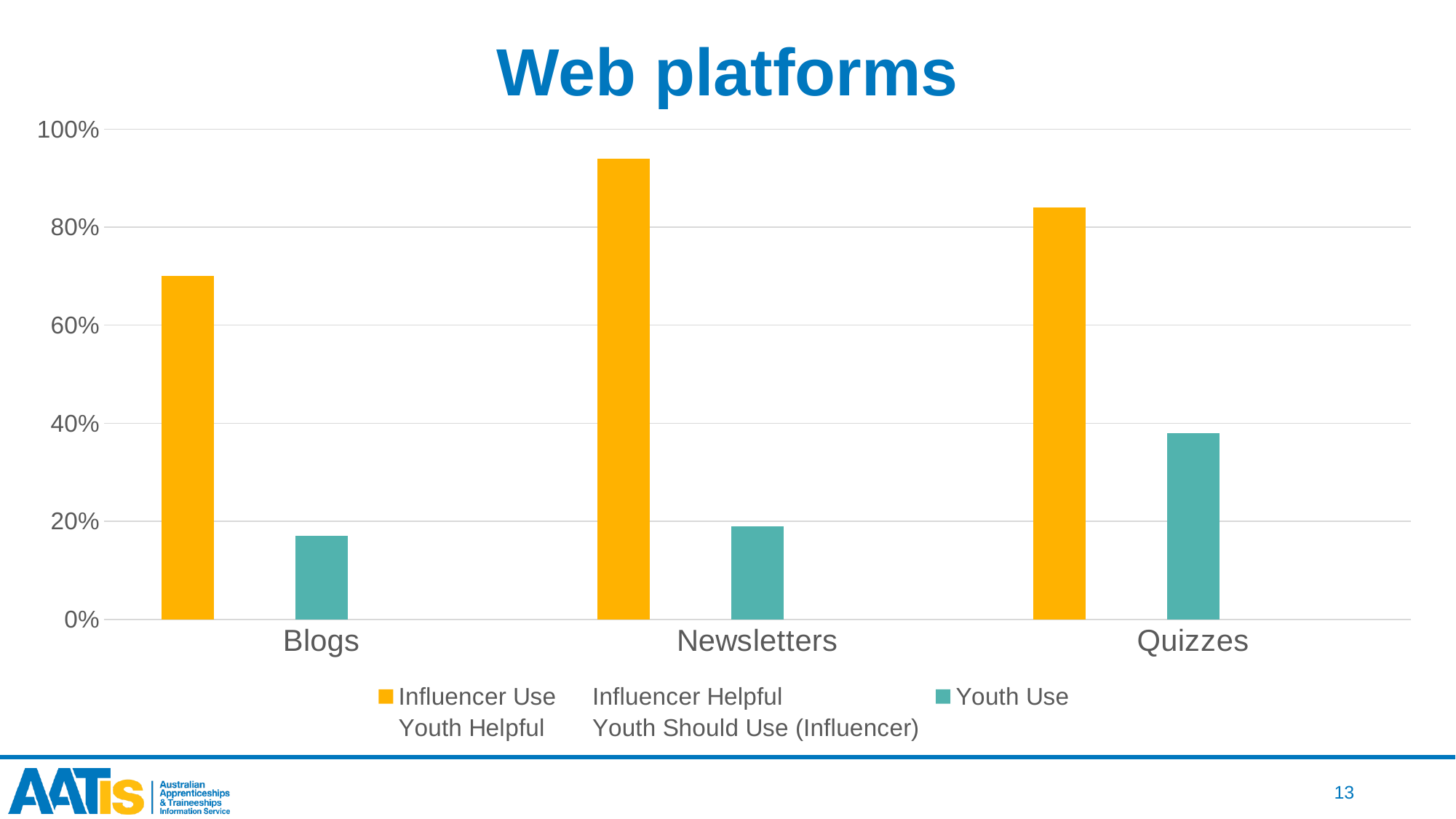
For Quizzes, which is larger: Influencer Use or Youth Use? Influencer Use Is the Youth Use value for Quizzes greater or less than 40%? less Which category has the lowest Influencer Use value? Blogs How many categories are shown on the x axis? 3 Which category has the highest Youth Use value? Quizzes Is the Youth Use value for Blogs greater or less than 20%? less Is the Influencer Use value for Newsletters greater or less than 80%? greater What colour are the Youth Use bars? teal What kind of chart is shown on the slide? bar chart What is the title of the chart? Web platforms Which category has the highest Influencer Use value? Newsletters